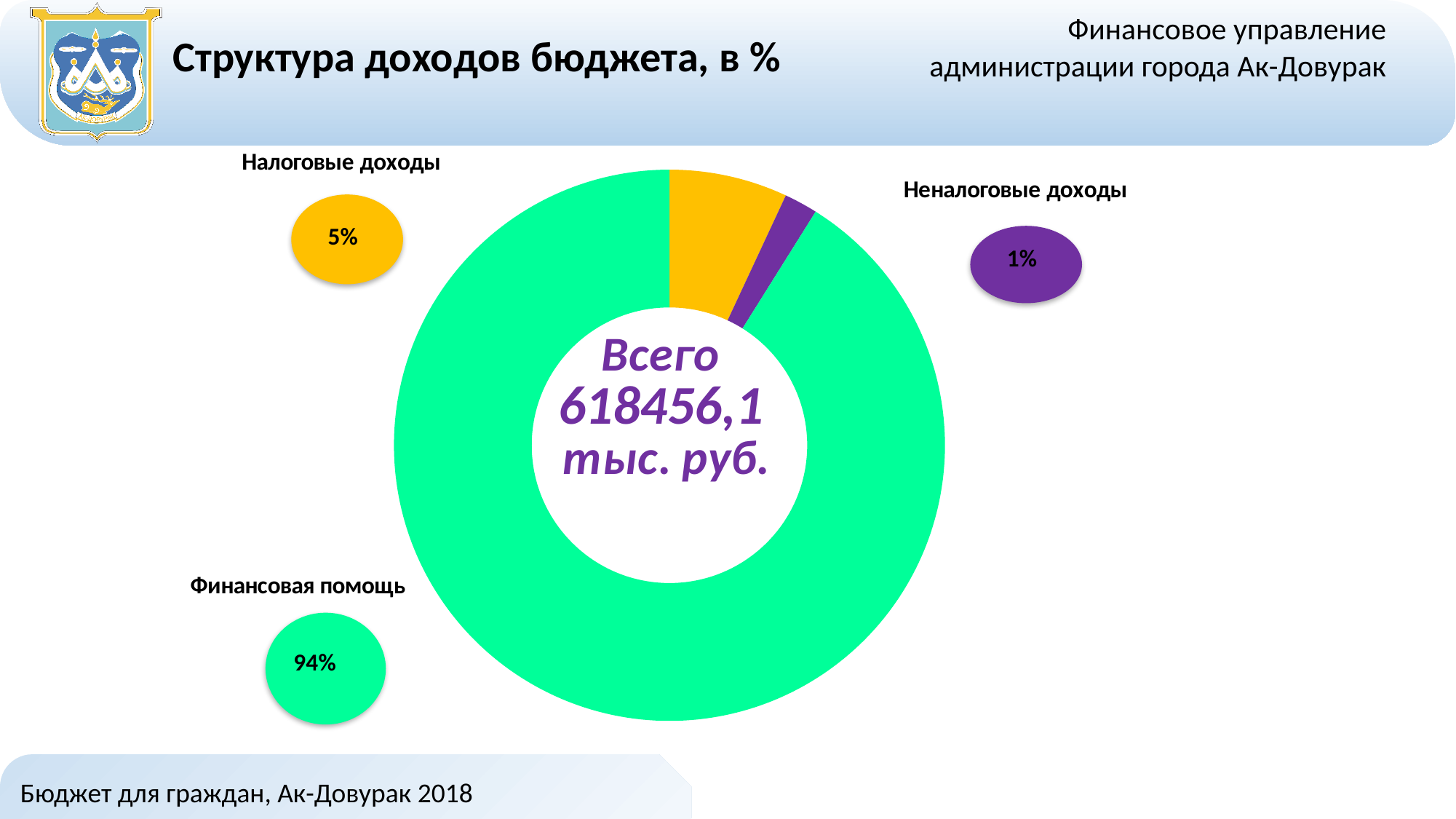
What total amount is shown in the centre of the chart? 618456,1 тыс. руб. How many revenue categories are shown in the chart? 3 What share of budget revenues comes from Неналоговые доходы? 1% What share of budget revenues comes from Финансовая помощь? 94% Which is larger: the share of Налоговые доходы or the share of Неналоговые доходы? Налоговые доходы What share of budget revenues comes from Налоговые доходы? 5% What kind of chart is shown on the slide? Pie chart (doughnut) What is the title of the chart? Структура доходов бюджета, в % Which revenue category has the largest share of the budget? Финансовая помощь Which revenue category has the smallest share of the budget? Неналоговые доходы What is the difference in percentage points between Финансовая помощь and Налоговые доходы? 89 What is the combined share of Налоговые доходы and Неналоговые доходы? 6%